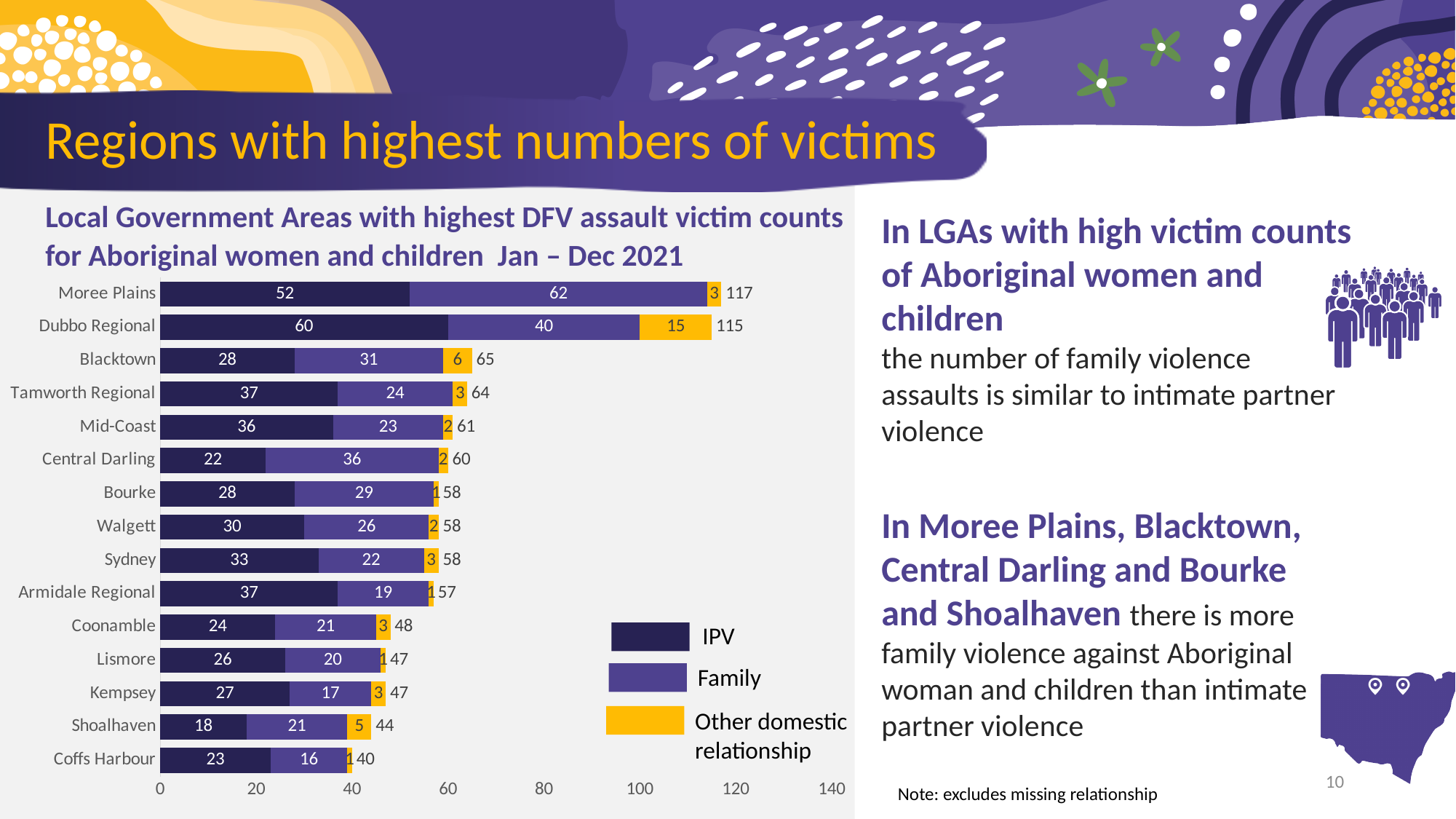
How many Local Government Areas are shown in the chart? 15 What is the total victim count for Blacktown? 65 What is the Other domestic relationship value for Shoalhaven? 5 What kind of chart is shown on the slide? Stacked bar chart What is the difference between the Family value and the IPV value for Central Darling? 14 How many series does the legend list? 3 What is the Family value for Moree Plains? 62 What is the IPV value for Dubbo Regional? 60 Which Local Government Area has the lowest total victim count? Coffs Harbour Which is larger for Tamworth Regional, the IPV value or the Family value? IPV Is the total victim count for Dubbo Regional greater or less than 100? greater Which Local Government Area has the highest total victim count? Moree Plains